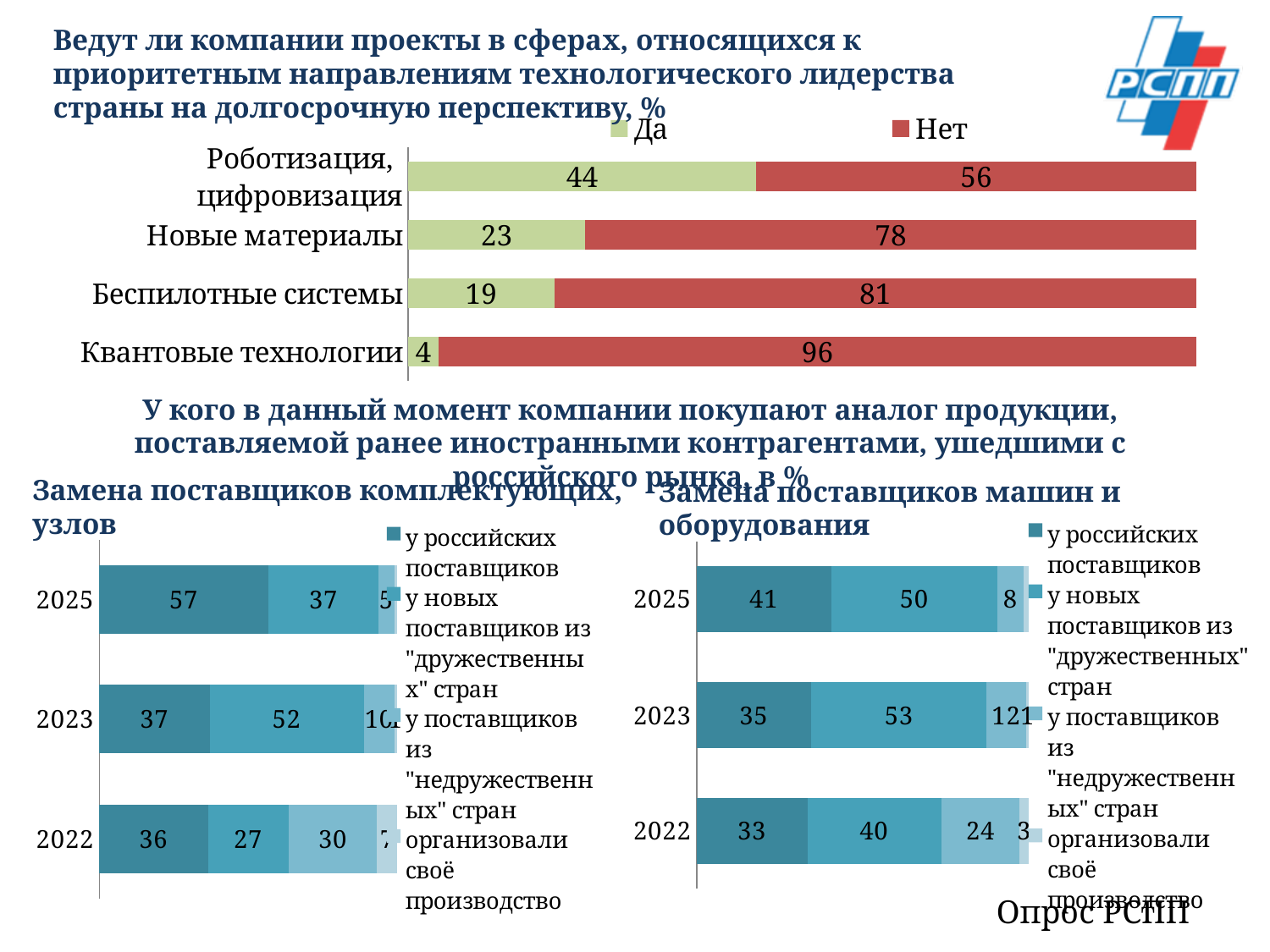
In the top chart on technological leadership projects, how many categories are shown? 4 In the bottom-left chart 'Замена поставщиков комплектующих, узлов', what is the value for 'у российских поставщиков' in 2025? 57 In the bottom-right chart 'Замена поставщиков машин и оборудования', how many series does the legend list? 4 In the bottom-right chart 'Замена поставщиков машин и оборудования', what is the total of the stacked bar for 2022? 100 In the top chart on technological leadership projects, which category has the lowest 'Да' value? Квантовые технологии In the bottom-right chart 'Замена поставщиков машин и оборудования', what is the value for 'у новых поставщиков из "дружественных" стран' in 2023? 53 In the top chart on technological leadership projects, what is the difference between the 'Нет' values for Беспилотные системы and Новые материалы? 3 In the top chart on technological leadership projects, which category has the highest 'Да' value? Роботизация, цифровизация In the bottom-left chart 'Замена поставщиков комплектующих, узлов', which year has the highest value for 'у новых поставщиков из "дружественных" стран'? 2023 In the top chart on technological leadership projects, what kind of chart is it? Stacked bar chart In the top chart on technological leadership projects, what is the 'Да' value for Роботизация, цифровизация? 44 In the top chart on technological leadership projects, what is the 'Нет' value for Квантовые технологии? 96